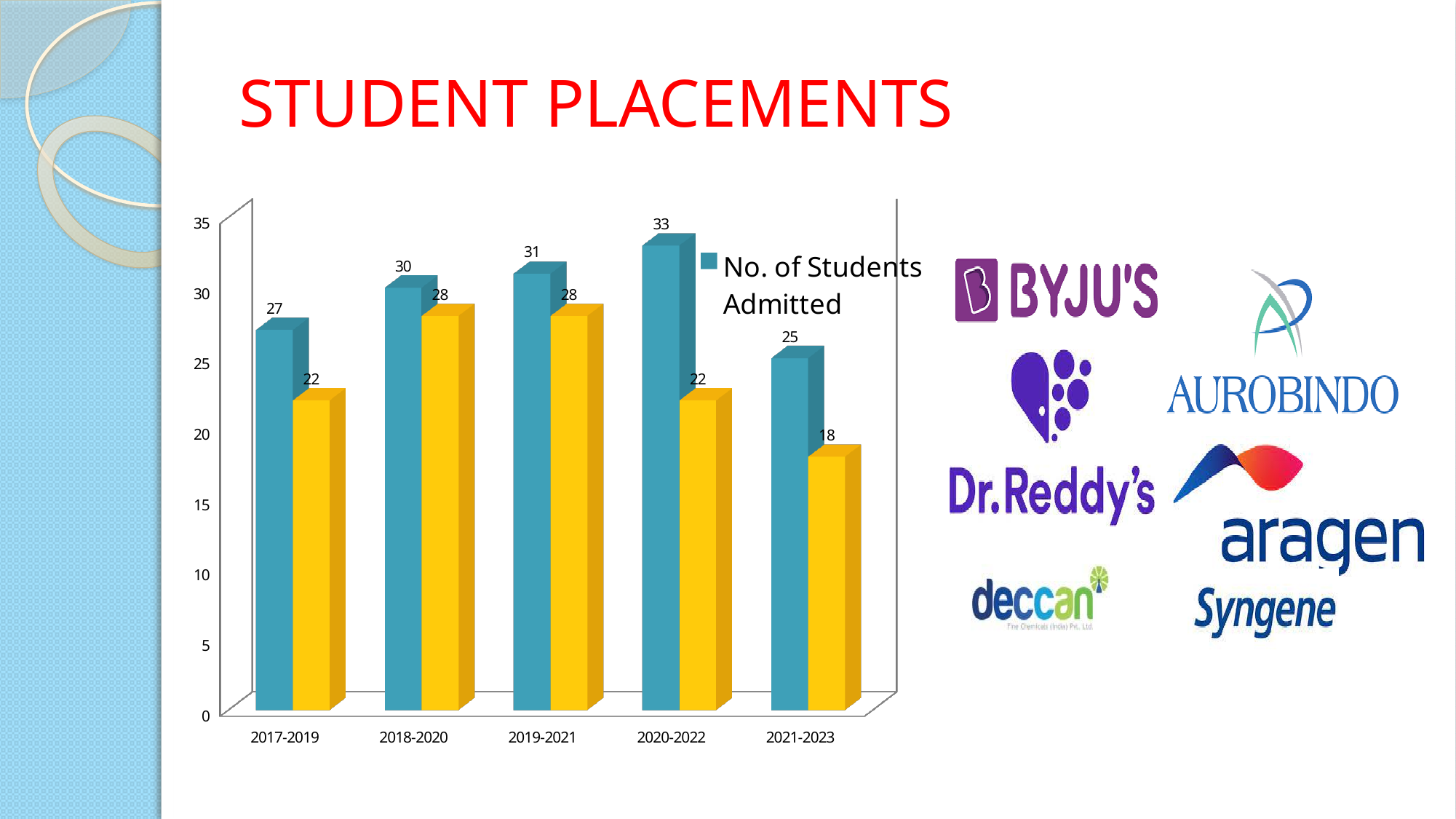
How many categories (year ranges) are shown on the x axis? 5 What is the value of No. of Students Admitted for 2017-2019? 27 What is the title of the slide containing the chart? STUDENT PLACEMENTS What is the value of the yellow bar for 2018-2020? 28 Which is larger: No. of Students Admitted for 2019-2021 or for 2018-2020? 2019-2021 Which year range has the highest No. of Students Admitted? 2020-2022 What is the value of No. of Students Admitted for 2020-2022? 33 What type of chart is shown on the slide? bar chart What is the difference between No. of Students Admitted and the yellow bar for 2020-2022? 11 Which year range has the lowest No. of Students Admitted? 2021-2023 What is the value of the yellow bar for 2021-2023? 18 What is the value of No. of Students Admitted for 2021-2023? 25